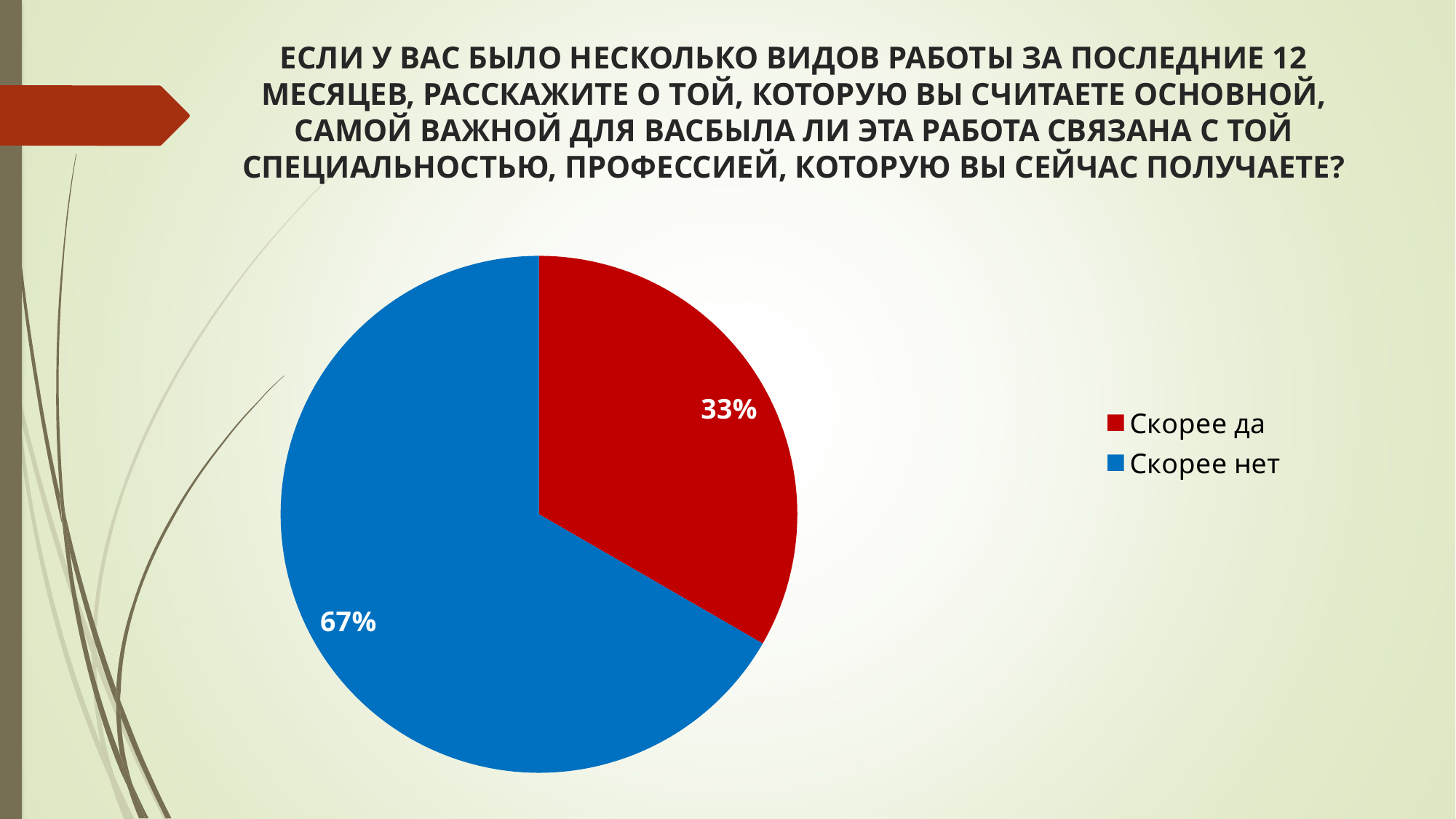
How many slices does the pie chart have? 2 Which category has the smallest slice of the pie? Скорее да What colour is the slice for "Скорее да"? red How many entries does the legend list? 2 What share of the pie is labelled "Скорее да"? 33% What share of the pie is labelled "Скорее нет"? 67% What is the difference in percentage points between "Скорее нет" and "Скорее да"? 34 What colour is the slice for "Скорее нет"? blue What kind of chart is shown on the slide? pie chart Which is larger: the slice for "Скорее да" or the slice for "Скорее нет"? Скорее нет Which category has the largest slice of the pie? Скорее нет